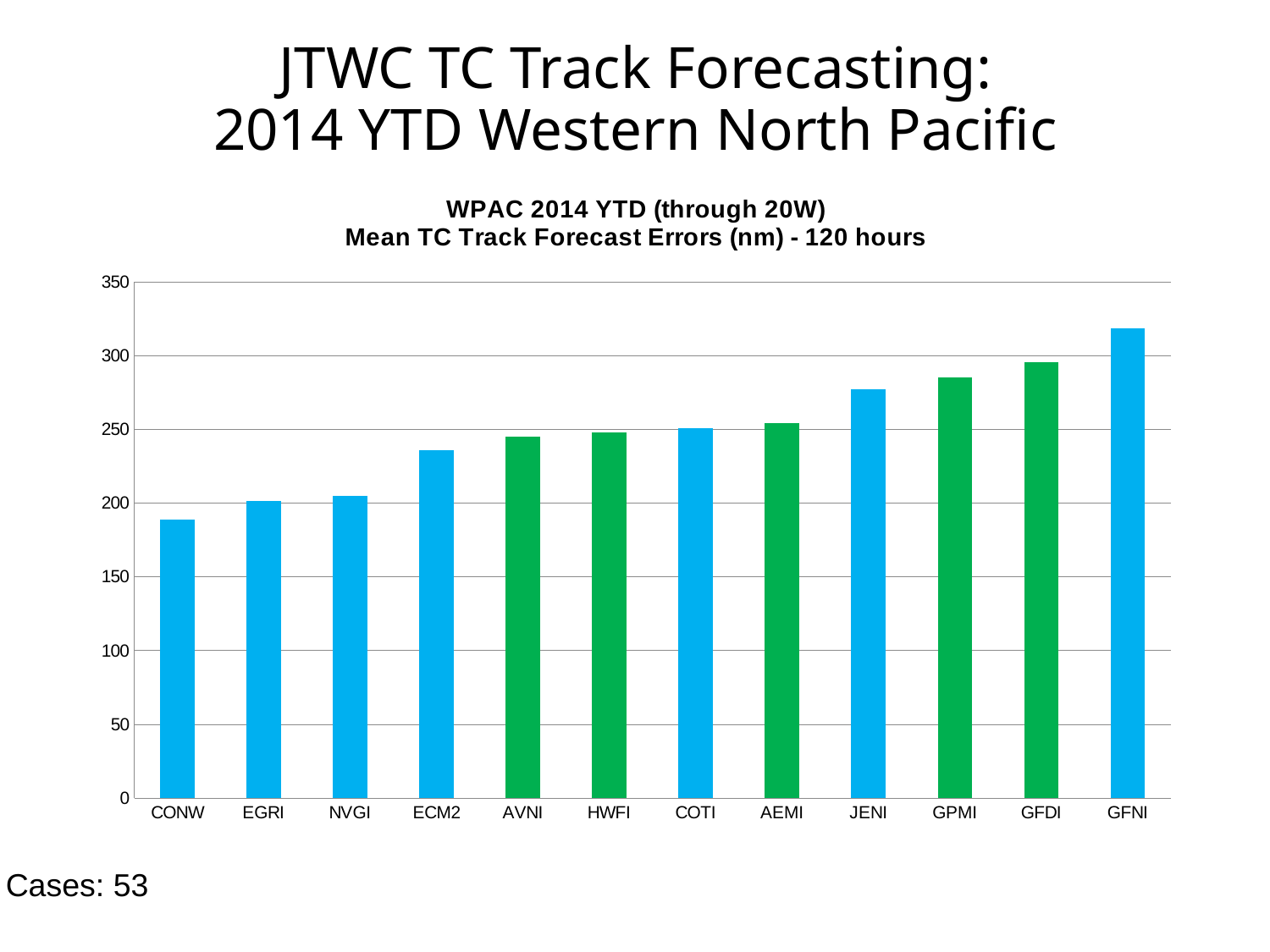
Is the value for CONW greater or less than 200? less What forecast lead time is given in the chart title? 120 hours Is the value for GFNI greater or less than 300? greater Is the value for GPMI greater or less than 300? less Do the bar values rise or fall moving from left to right along the x axis? rise Which has a larger mean track forecast error, JENI or ECM2? JENI Which model has the highest mean track forecast error at 120 hours? GFNI What kind of chart is shown on the slide? bar chart How many models (categories) are plotted on the chart? 12 Which model has the lowest mean track forecast error at 120 hours? CONW